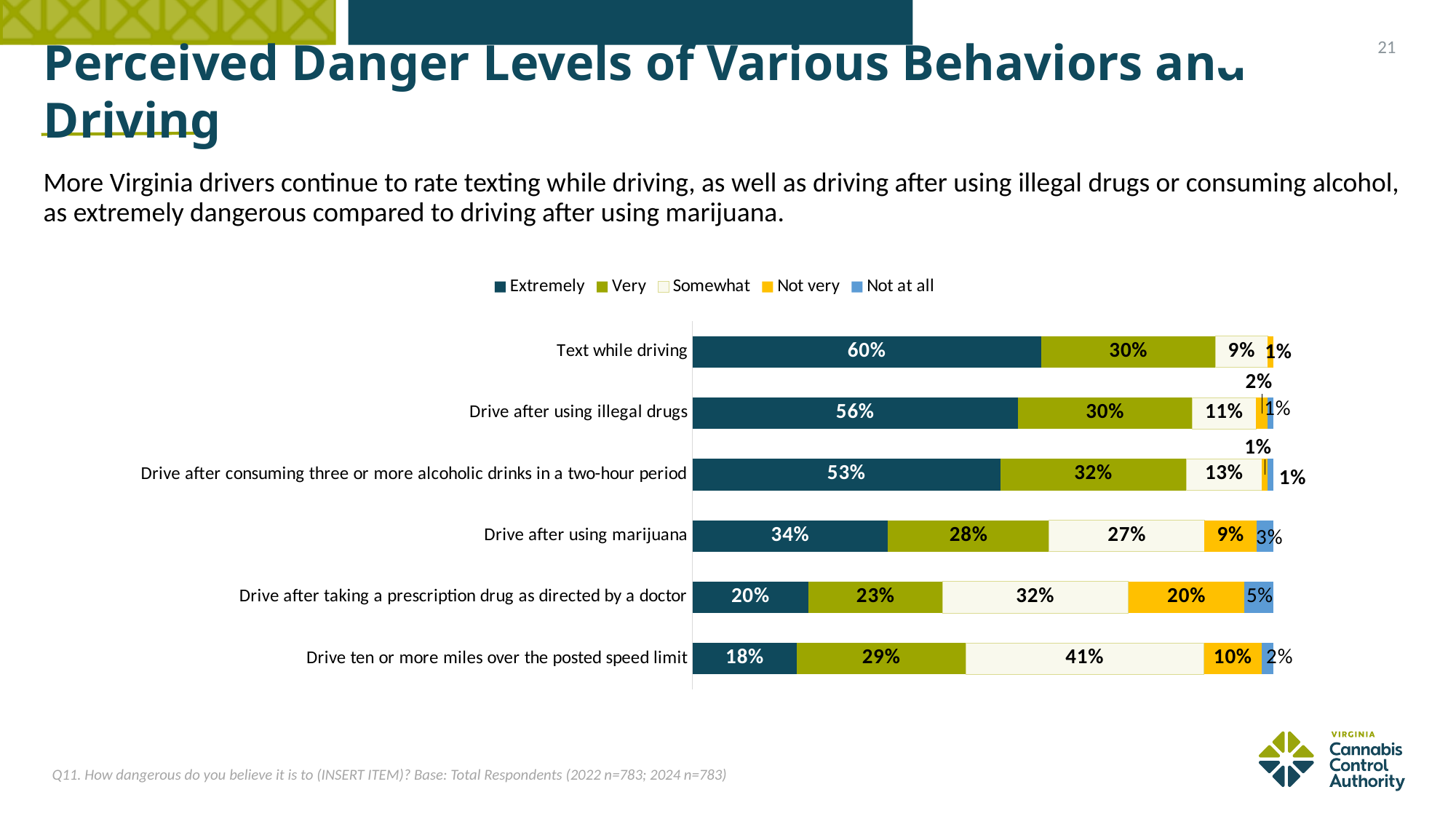
How many percentage points higher is the Extremely rating for 'Text while driving' than for 'Drive after using marijuana'? 26 percentage points What type of chart is shown on the slide? Stacked bar chart How many series does the legend list? 5 What is the Not very value for 'Drive after taking a prescription drug as directed by a doctor'? 20% Which behavior has the lowest Extremely dangerous rating? Drive ten or more miles over the posted speed limit How many behaviors are shown in the chart? 6 What is the combined Extremely and Very percentage for 'Drive after using marijuana'? 62% Which behavior has the highest Extremely dangerous rating? Text while driving What percentage of respondents rated texting while driving as Extremely dangerous? 60% What is the Not at all value for 'Drive after using marijuana'? 3% Which has a larger Very rating: 'Drive after consuming three or more alcoholic drinks in a two-hour period' or 'Drive after using illegal drugs'? Drive after consuming three or more alcoholic drinks in a two-hour period What is the Somewhat value for 'Drive ten or more miles over the posted speed limit'? 41%